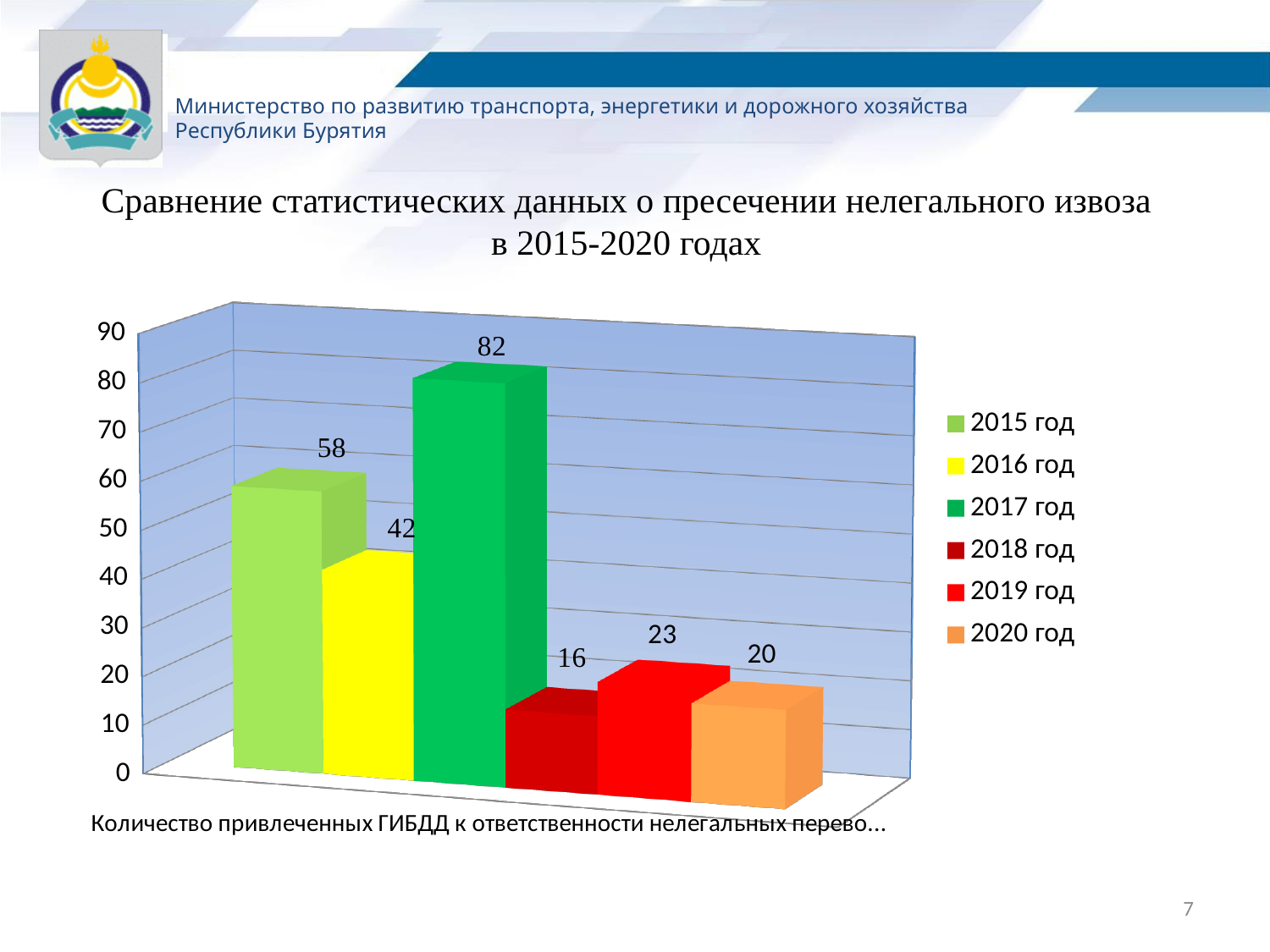
What is the difference between the values for 2017 год and 2016 год? 40 What is the value for 2017 год? 82 Which is larger, the value for 2019 год or the value for 2020 год? 2019 год How many series does the legend list? 6 What kind of chart is shown on the slide? bar chart Do the values rise or fall from 2017 год to 2018 год? fall What is the value for 2019 год? 23 Which year has the lowest value? 2018 год What is the value for 2015 год? 58 What colour is the bar for 2016 год? yellow Is the value for 2016 год greater or less than 50? less Which year has the highest value? 2017 год